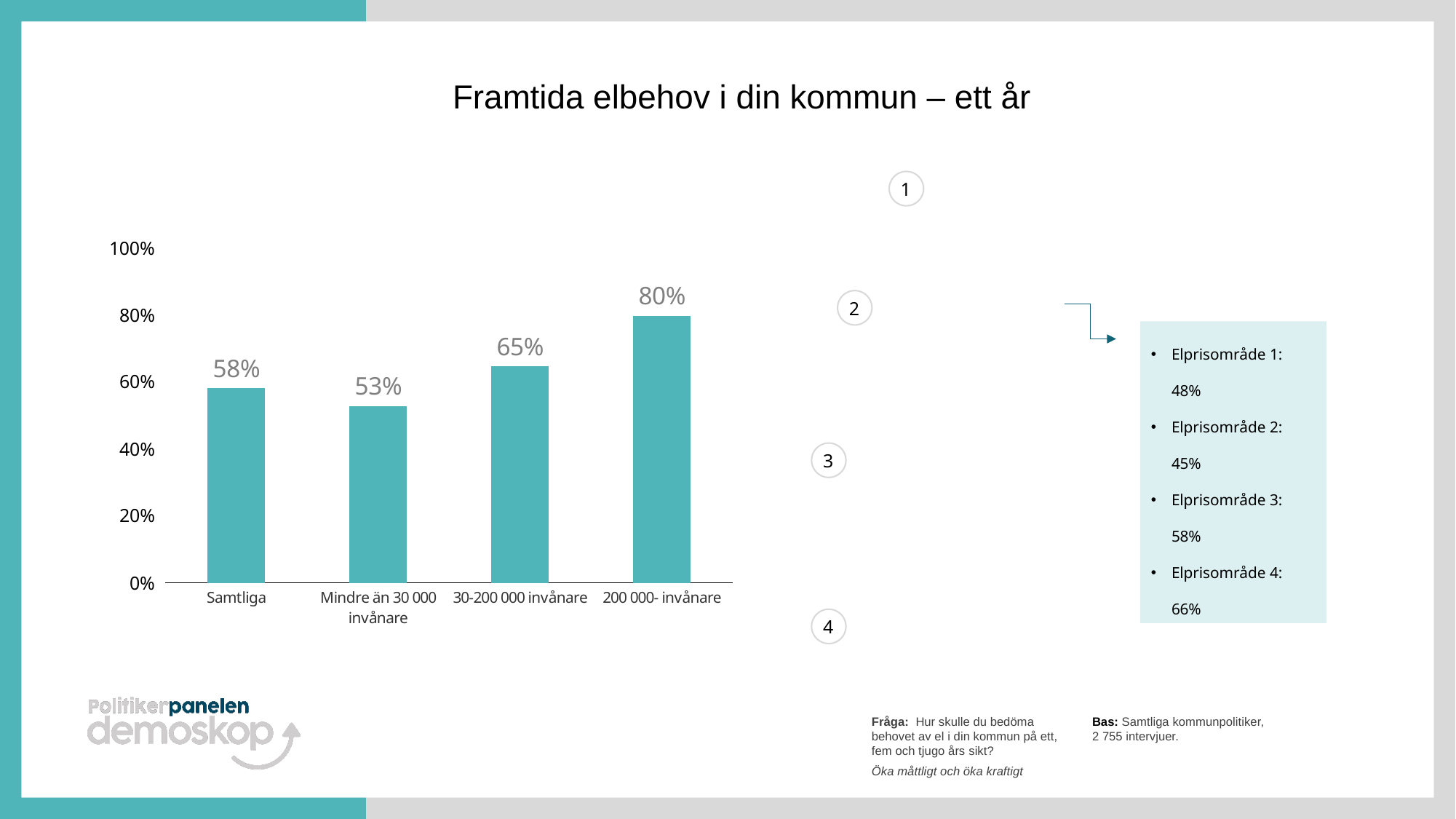
What is the value for Samtliga? 58% What is the title of the chart? Framtida elbehov i din kommun – ett år What is the value for 30-200 000 invånare? 65% How many categories are shown on the x axis? 4 What is the value for 200 000- invånare? 80% What is the value for Mindre än 30 000 invånare? 53% Is the value for 200 000- invånare greater or less than 60%? greater What is the difference between the values for 200 000- invånare and Samtliga? 22% Which category has the highest value? 200 000- invånare Which is larger, the value for 30-200 000 invånare or the value for Mindre än 30 000 invånare? 30-200 000 invånare Which category has the lowest value? Mindre än 30 000 invånare What kind of chart is shown on the slide? bar chart